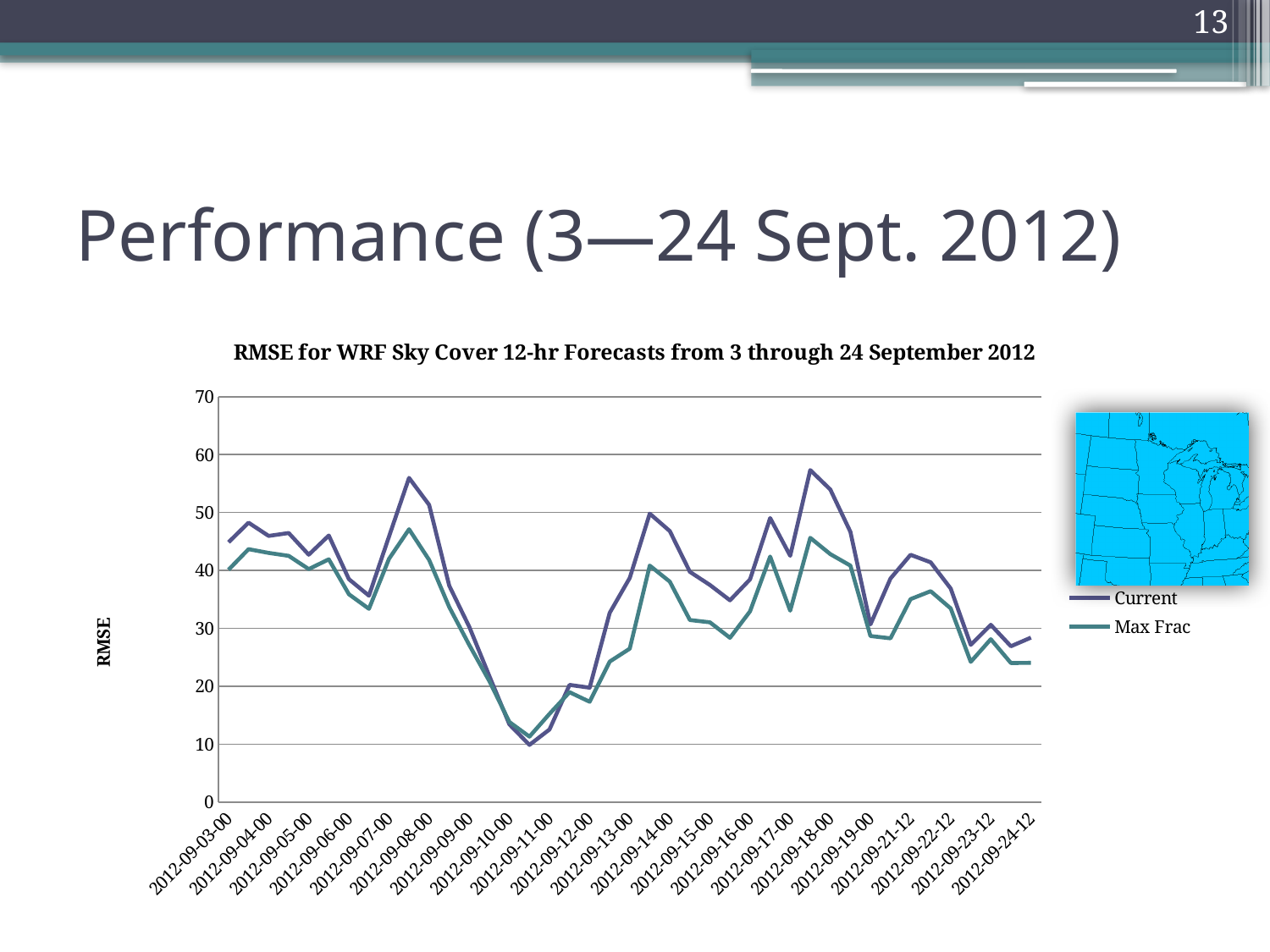
Do the RMSE values rise or fall between 2012-09-08-00 and 2012-09-11-00? fall What is the label on the vertical axis of the chart? RMSE Is the Current value at 2012-09-11-00 greater or less than 20? less Is the Max Frac value at 2012-09-08-00 greater or less than 50? less Is the Current value at 2012-09-08-00 greater or less than 50? greater How many series does the legend list? 2 What kind of chart is shown on the slide? line chart Do the RMSE values rise or fall between 2012-09-11-00 and 2012-09-14-00? rise At 2012-09-18-00, which series has the higher RMSE, Current or Max Frac? Current What is the title of the chart? RMSE for WRF Sky Cover 12-hr Forecasts from 3 through 24 September 2012